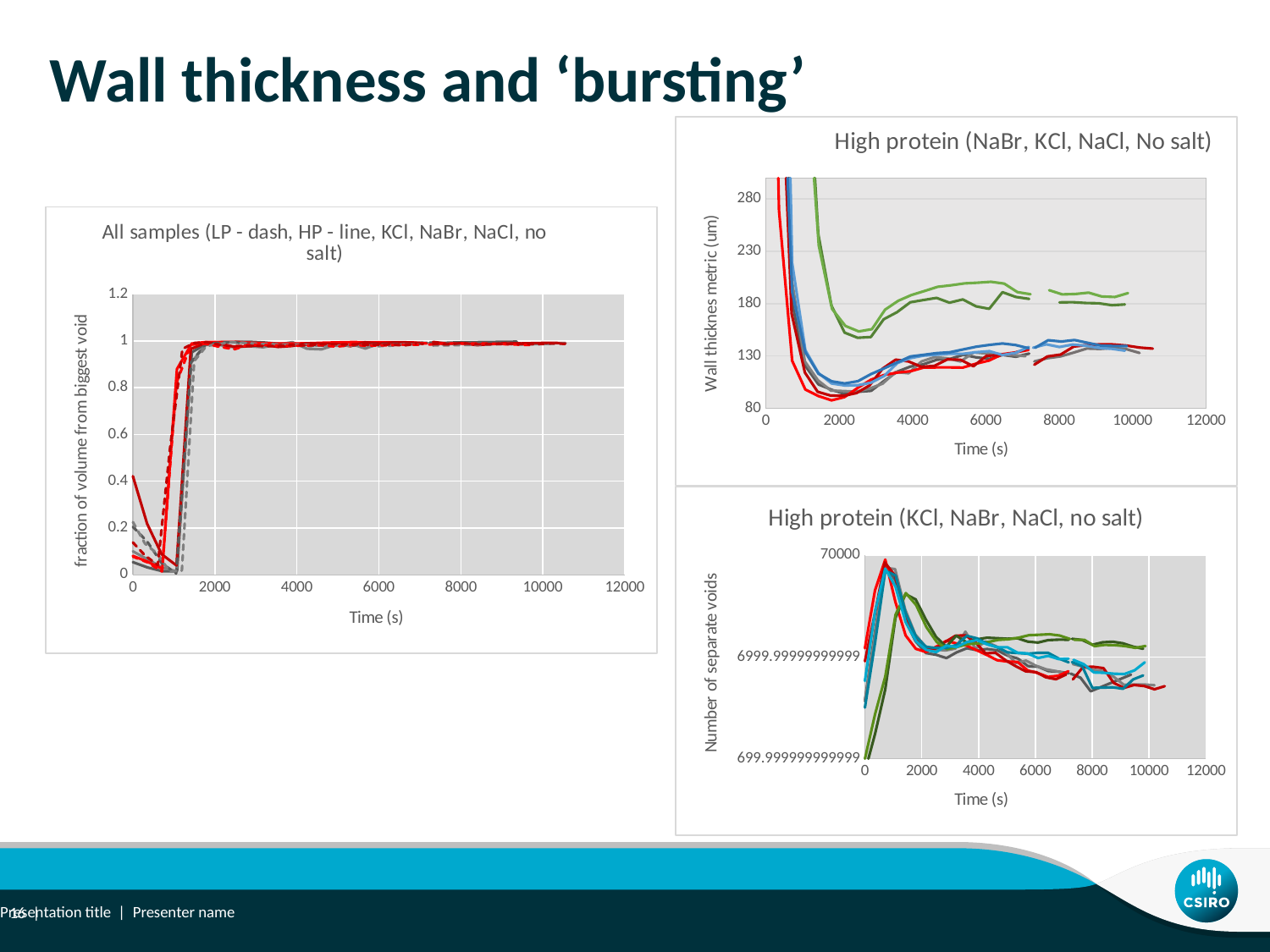
What is the y-axis title of the top-right chart 'High protein (NaBr, KCl, NaCl, No salt)'? Wall thickness metric (um) In the top-right chart 'High protein (NaBr, KCl, NaCl, No salt)', do the wall thickness values rise or fall as time increases from 0 to 2000 s? fall In the bottom-right chart 'High protein (KCl, NaBr, NaCl, no salt)', is the value of the green line at 6000 s greater or less than 70000? less In the left chart 'All samples', do the values rise or fall as time increases from 1000 to 2000 s? rise What kind of chart is the left chart titled 'All samples (LP - dash, HP - line, KCl, NaBr, NaCl, no salt)'? line chart In the left chart 'All samples', are the values at 6000 s greater or less than 0.8? greater What kind of chart is the top-right chart titled 'High protein (NaBr, KCl, NaCl, No salt)'? line chart In the bottom-right chart 'High protein (KCl, NaBr, NaCl, no salt)', do the values rise or fall as time increases from 2000 to 10000 s? fall What is the y-axis title of the bottom-right chart 'High protein (KCl, NaBr, NaCl, no salt)'? Number of separate voids In the top-right chart 'High protein (NaBr, KCl, NaCl, No salt)', is the value of the blue line at 2000 s greater or less than 130? less How many charts are shown on the slide? 3